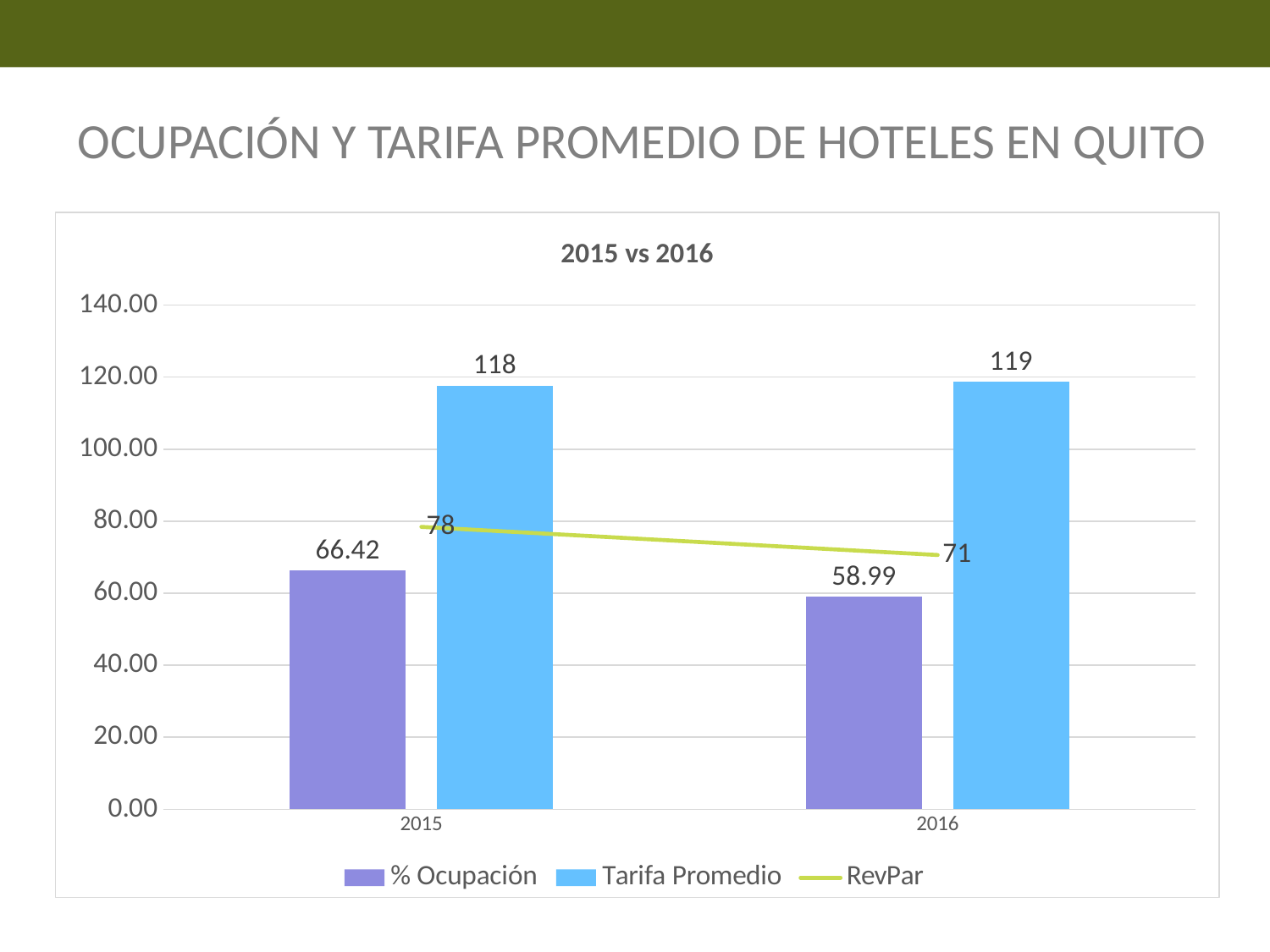
What is the difference between the RevPar values for 2015 and 2016? 7 What is the % Ocupación value for 2016? 58.99 What is the % Ocupación value for 2015? 66.42 What is the difference between the % Ocupación values for 2015 and 2016? 7.43 How many series does the legend list? 3 What is the title of the chart? 2015 vs 2016 What is the RevPar value for 2016? 71 Which year has the higher Tarifa Promedio, 2015 or 2016? 2016 Does the RevPar line rise or fall from 2015 to 2016? fall What is the Tarifa Promedio value for 2016? 119 What is the RevPar value for 2015? 78 How many years are shown on the x axis? 2